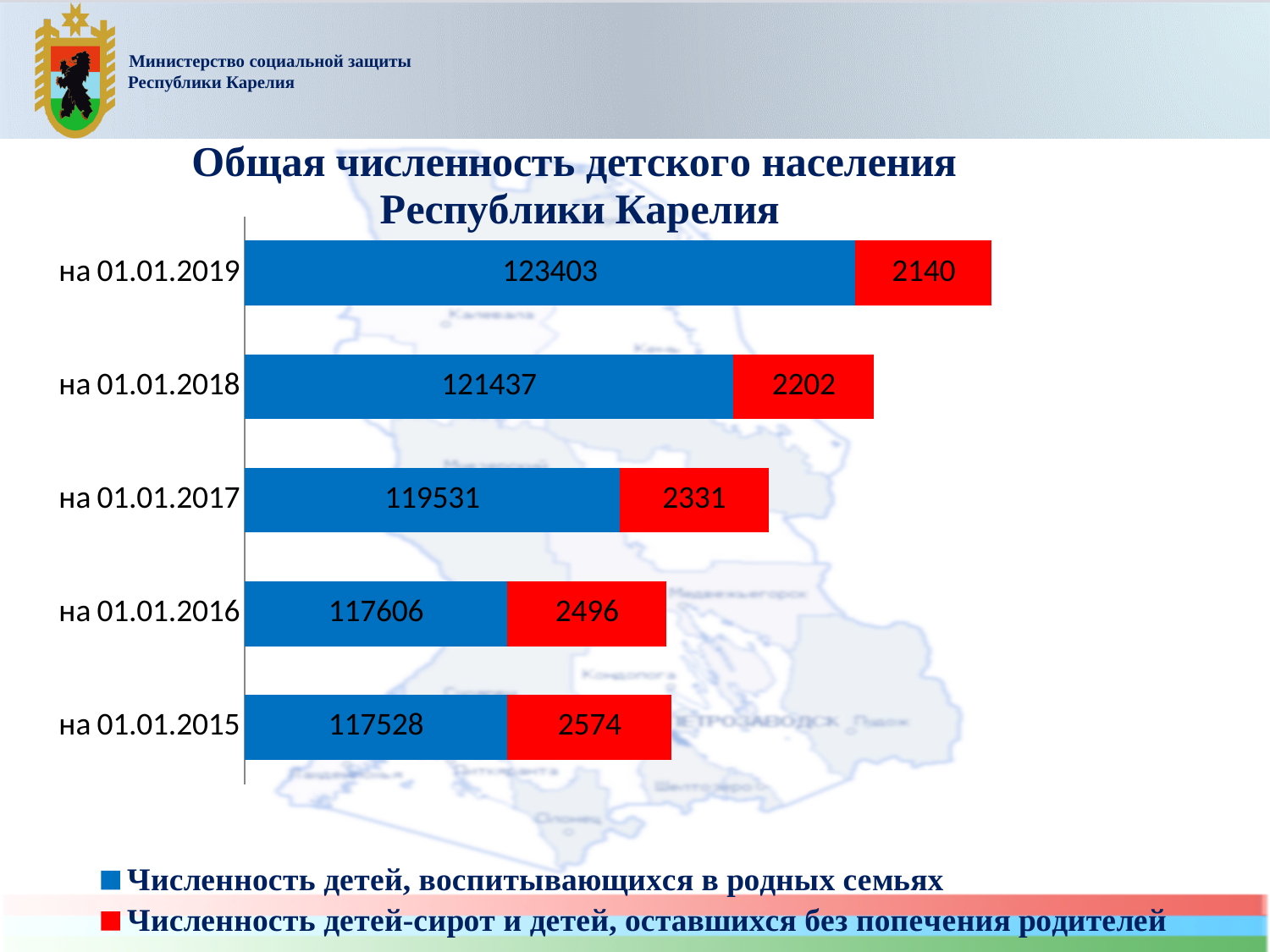
What type of chart is shown on the slide? Stacked bar chart On which date is the number of orphans and children left without parental care the highest? на 01.01.2015 How many series does the legend list? 2 What is the number of children raised in their own families as of 01.01.2015? 117528 How does the number of orphans and children left without parental care change from 01.01.2015 to 01.01.2019? It falls Which is larger: the number of orphans as of 01.01.2017 or as of 01.01.2018? на 01.01.2017 What is the number of orphans and children left without parental care (Численность детей-сирот) as of 01.01.2016? 2496 What is the number of children raised in their own families (Численность детей, воспитывающихся в родных семьях) as of 01.01.2019? 123403 On which date is the number of children raised in their own families the lowest? на 01.01.2015 What is the total child population (both series combined) as of 01.01.2019? 125543 What is the difference between the number of orphans as of 01.01.2015 and as of 01.01.2019? 434 How many dates (categories) are shown on the chart? 5